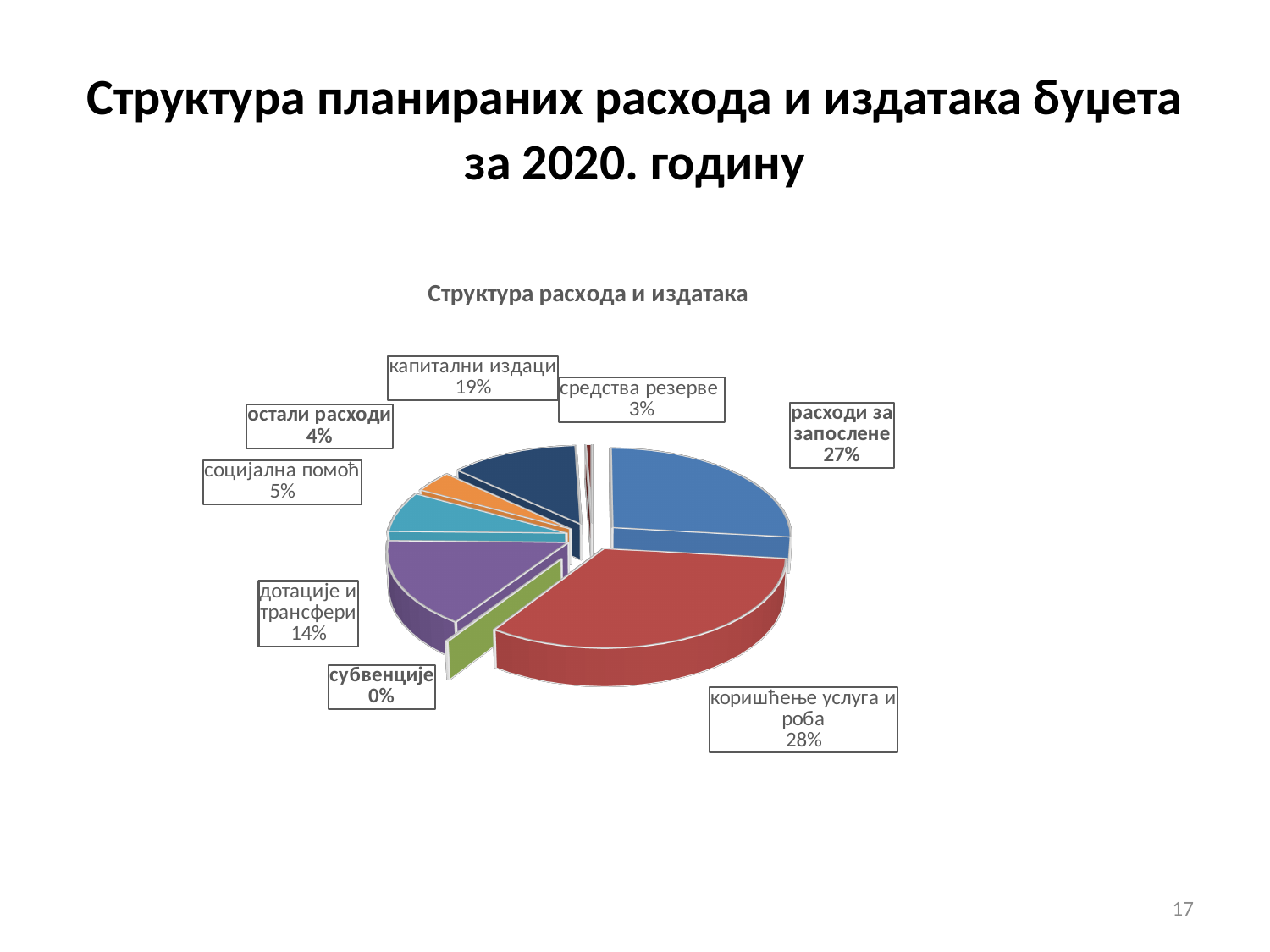
Which category has the smallest share of the pie? субвенције What share of the pie does "коришћење услуга и роба" have? 28% How many categories are shown in the pie chart? 8 What kind of chart is shown on the slide? pie chart Which has a larger share, "социјална помоћ" or "остали расходи"? социјална помоћ Which category has the largest share of the pie? коришћење услуга и роба What share of the pie does "дотације и трансфери" have? 14% What share of the pie does "расходи за запослене" have? 27% What is the title of the chart? Структура расхода и издатака What is the difference between the shares of "капитални издаци" and "дотације и трансфери"? 5%